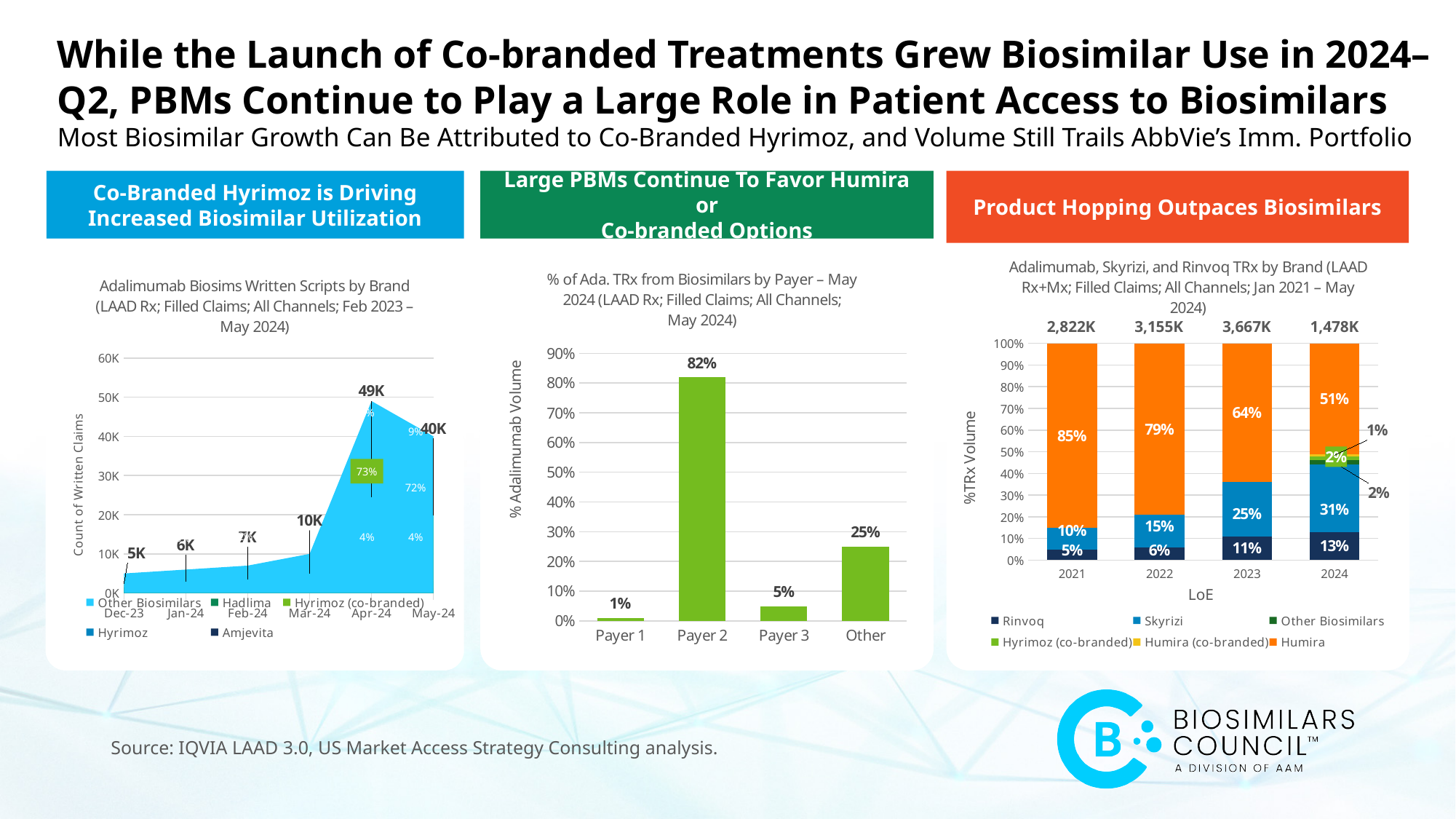
In the right chart (Adalimumab, Skyrizi, and Rinvoq TRx by Brand), what is the total TRx volume labelled above the 2022 bar? 3,155K In the left chart (Adalimumab Biosims Written Scripts by Brand), how many series does the legend list? 5 In the left chart (Adalimumab Biosims Written Scripts by Brand), which month has the highest total written claims? Apr-24 In the middle chart (% of Ada. TRx from Biosimilars by Payer), what is the difference between the values for Other and Payer 3? 20% In the right chart (Adalimumab, Skyrizi, and Rinvoq TRx by Brand), how many series does the legend list? 6 What kind of chart is the middle chart (% of Ada. TRx from Biosimilars by Payer)? Bar chart In the right chart (Adalimumab, Skyrizi, and Rinvoq TRx by Brand), what share of TRx volume does Humira have in 2023? 64% In the middle chart (% of Ada. TRx from Biosimilars by Payer), which payer category has the lowest value? Payer 1 In the middle chart (% of Ada. TRx from Biosimilars by Payer), what is the value for Payer 2? 82% In the middle chart (% of Ada. TRx from Biosimilars by Payer), how many payer categories are shown on the x axis? 4 In the left chart (Adalimumab Biosims Written Scripts by Brand), what is the total count of written claims labelled for Apr-24? 49K In the right chart (Adalimumab, Skyrizi, and Rinvoq TRx by Brand), does the Humira share rise or fall from 2021 to 2024? Fall